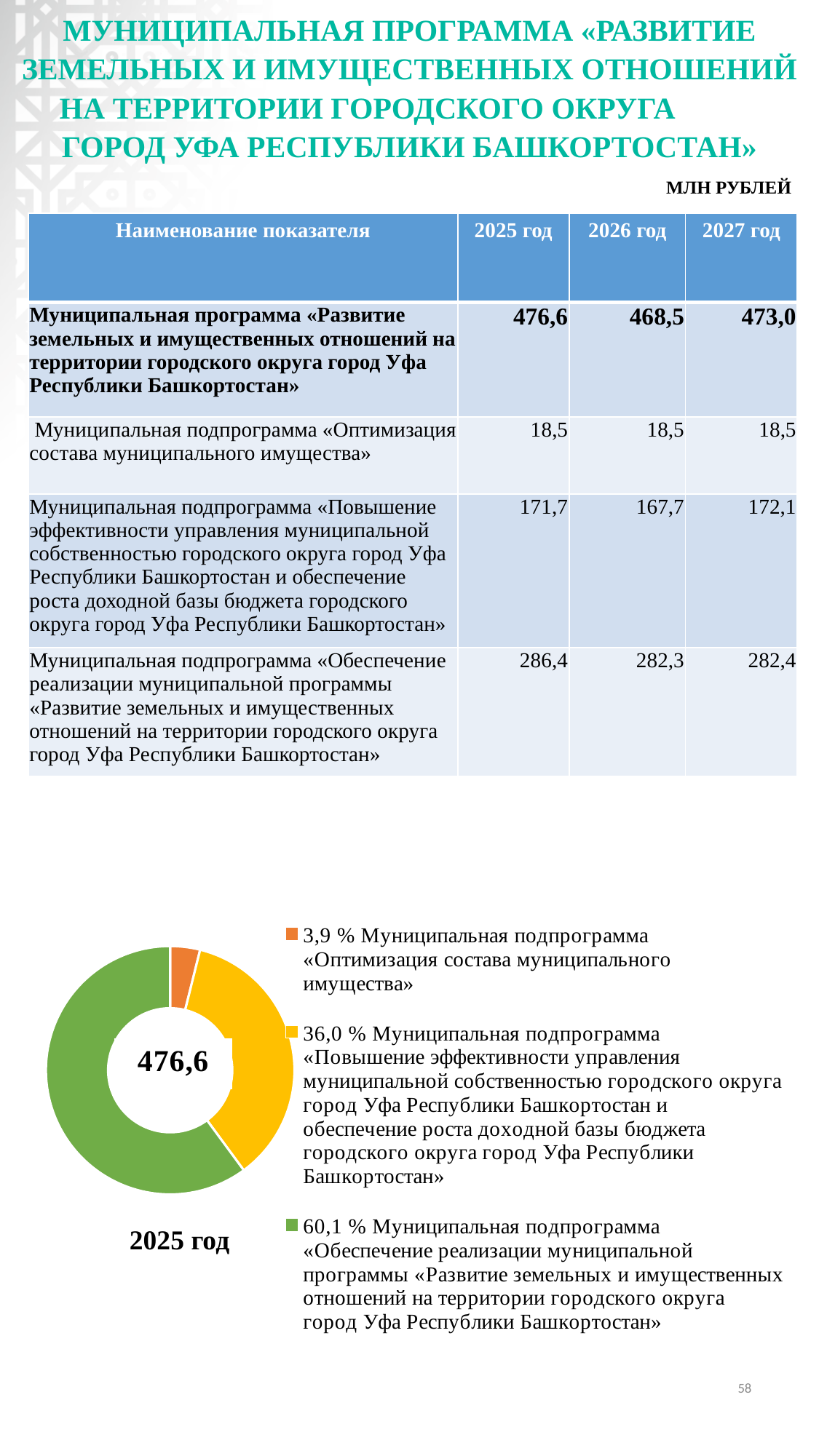
What share of the doughnut chart does the subprogramme «Оптимизация состава муниципального имущества» take? 3,9 % What total value is printed in the centre of the doughnut chart? 476,6 What kind of chart is shown at the bottom of the slide? doughnut (pie) chart Which subprogramme has the smallest slice in the doughnut chart? Муниципальная подпрограмма «Оптимизация состава муниципального имущества» How many slices does the doughnut chart for 2025 год have? 3 Which subprogramme has the largest slice in the doughnut chart? Муниципальная подпрограмма «Обеспечение реализации муниципальной программы «Развитие земельных и имущественных отношений на территории городского округа город Уфа Республики Башкортостан» What share of the doughnut chart does the subprogramme «Повышение эффективности управления муниципальной собственностью...» take? 36,0 % What share of the doughnut chart does the subprogramme «Обеспечение реализации муниципальной программы...» take? 60,1 % What is the difference in percentage points between the 60,1 % slice and the 36,0 % slice in the doughnut chart? 24,1 % In the doughnut chart, which slice is larger: «Оптимизация состава муниципального имущества» or «Повышение эффективности управления муниципальной собственностью...»? «Повышение эффективности управления муниципальной собственностью...» Which year does the doughnut chart represent? 2025 год What colour is the slice for the subprogramme «Оптимизация состава муниципального имущества» in the doughnut chart? orange